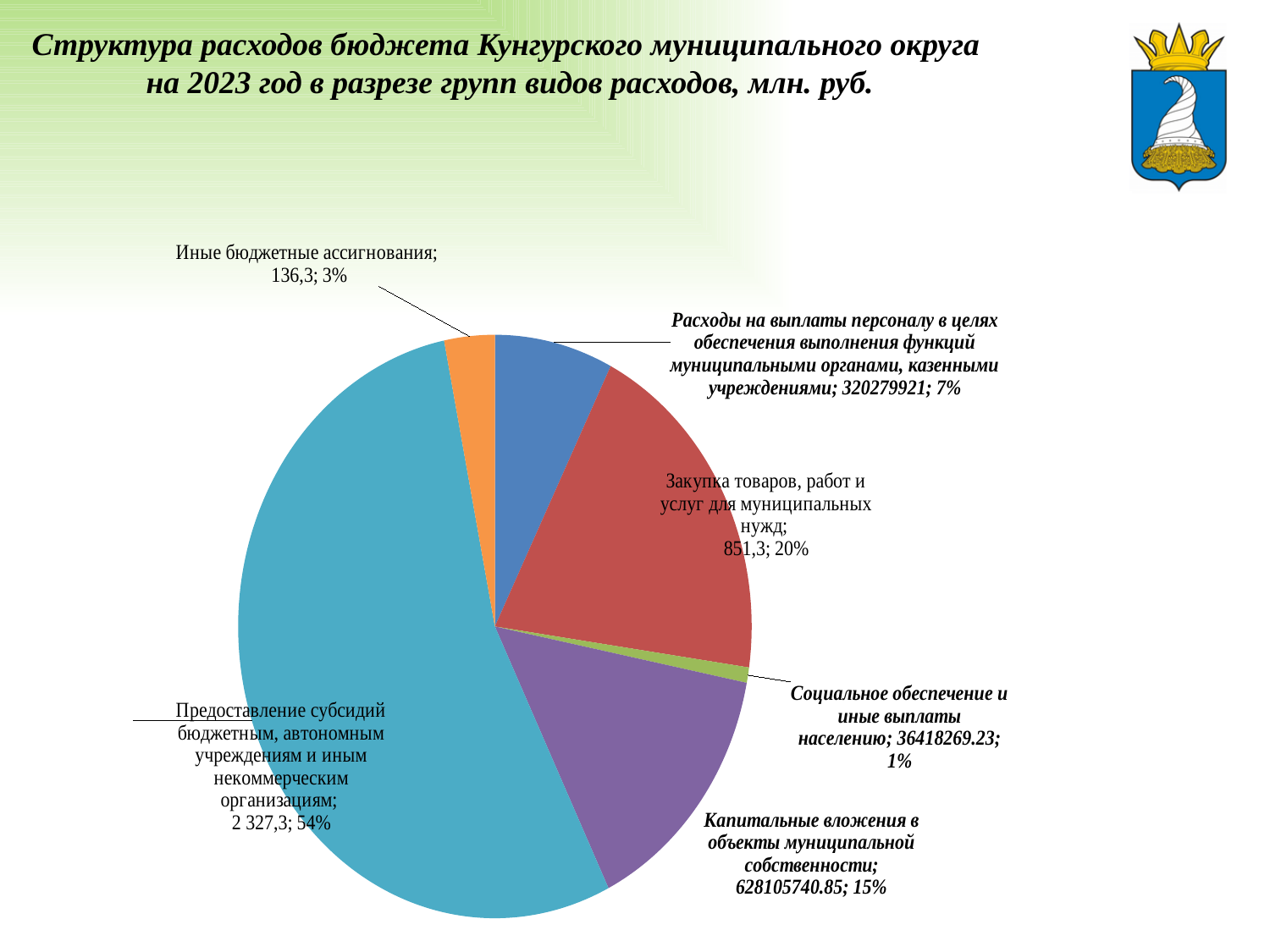
What share of the pie does "Закупка товаров, работ и услуг для муниципальных нужд" have? 20% Which category has the largest share of the pie? Предоставление субсидий бюджетным, автономным учреждениям и иным некоммерческим организациям What value is shown for "Иные бюджетные ассигнования"? 136,3 Which has a larger share: "Закупка товаров, работ и услуг для муниципальных нужд" or "Капитальные вложения в объекты муниципальной собственности"? Закупка товаров, работ и услуг для муниципальных нужд What value is shown for "Закупка товаров, работ и услуг для муниципальных нужд"? 851,3 What is the difference in percentage points between the share of "Предоставление субсидий бюджетным, автономным учреждениям и иным некоммерческим организациям" and the share of "Закупка товаров, работ и услуг для муниципальных нужд"? 34 percentage points Which category has the smallest share of the pie? Социальное обеспечение и иные выплаты населению What kind of chart is shown on the slide? pie chart What value is shown for "Социальное обеспечение и иные выплаты населению"? 36418269.23 What share of the pie does "Капитальные вложения в объекты муниципальной собственности" have? 15% How many slices does the pie chart have? 6 What share of the pie does "Предоставление субсидий бюджетным, автономным учреждениям и иным некоммерческим организациям" have? 54%